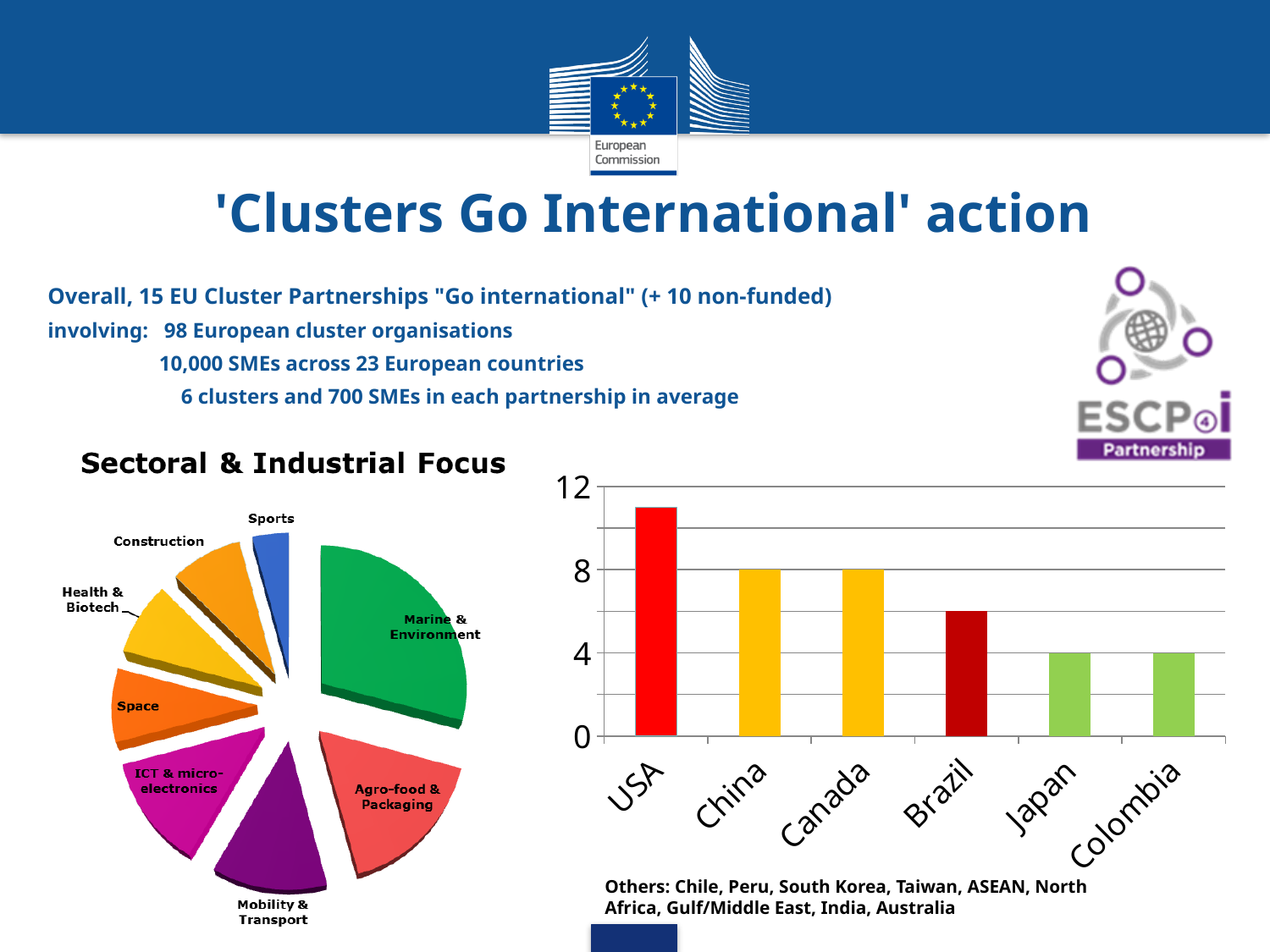
On the bar chart on the right, what is the value for China? 8 How many countries are shown on the bar chart on the right? 6 How many slices does the 'Sectoral & Industrial Focus' pie chart have? 8 In the 'Sectoral & Industrial Focus' chart, which sector has the largest slice? Marine & Environment On the bar chart on the right, what is the value for Canada? 8 In the 'Sectoral & Industrial Focus' chart, which sector has the smallest slice? Sports On the bar chart on the right, is the value for USA greater or less than 8? greater On the bar chart on the right, which country has the highest bar? USA On the bar chart on the right, what is the value for Japan? 4 What kind of chart is the chart on the right of the slide? bar chart On the bar chart on the right, is the value for Brazil greater or less than 8? less On the bar chart on the right, which is larger, the value for Brazil or the value for Colombia? Brazil